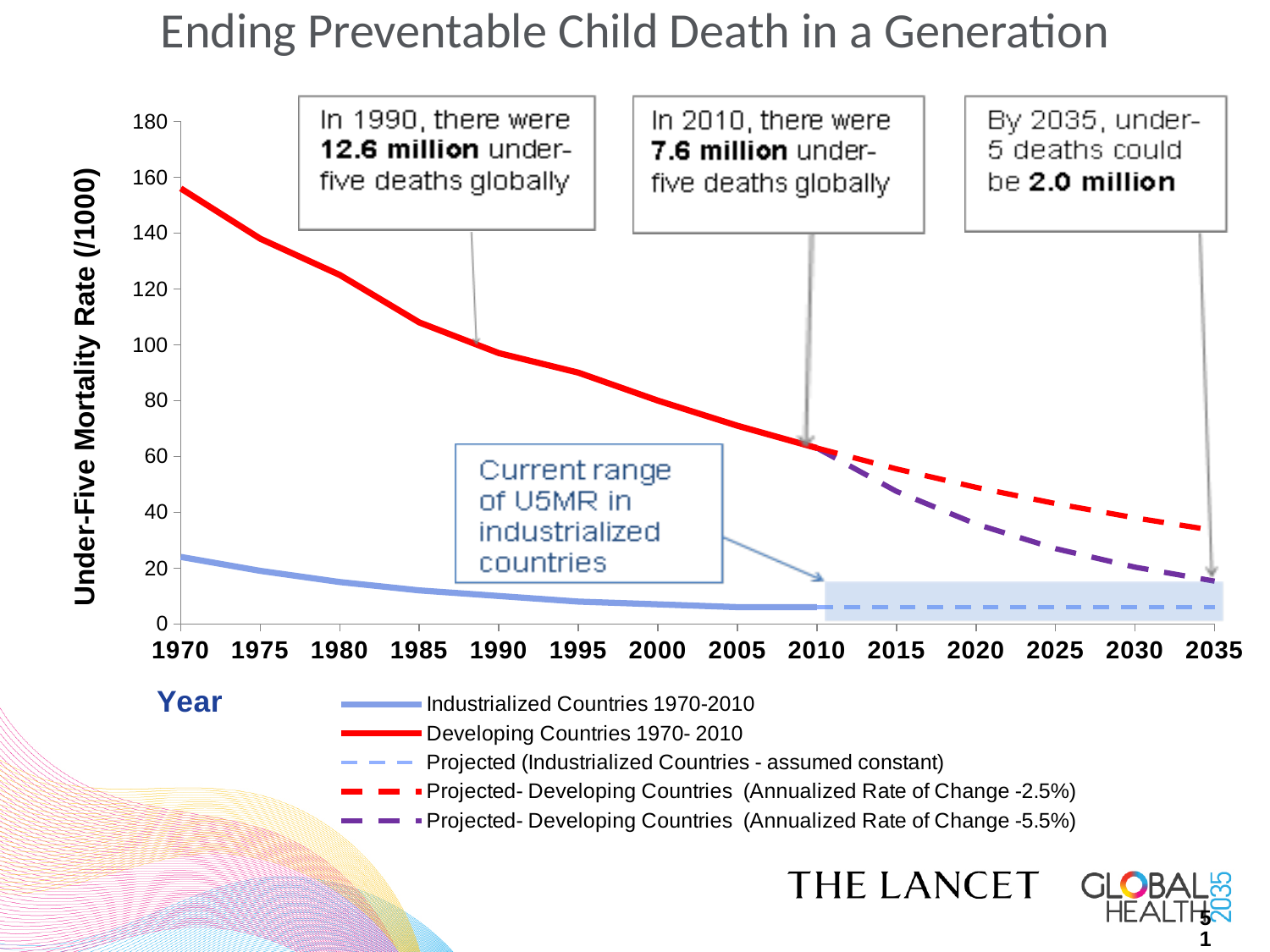
How many series does the legend list? 5 Is the under-five mortality rate for Industrialized Countries in 1970 greater or less than 40? less Is the under-five mortality rate for Developing Countries in 1970 greater or less than 140? greater What kind of chart is shown on the slide? line chart According to the annotation, how many under-five deaths were there globally in 1990? 12.6 million In 1990, which series has the higher under-five mortality rate: Developing Countries or Industrialized Countries? Developing Countries According to the annotation, how many under-5 deaths could there be by 2035? 2.0 million What is the label of the y axis? Under-Five Mortality Rate (/1000) Is the projected 2035 value for Developing Countries at an annualized rate of change of -2.5% greater or less than 40? less Does the under-five mortality rate for Developing Countries rise or fall from 1970 to 2010? fall According to the annotation, how many under-five deaths were there globally in 2010? 7.6 million